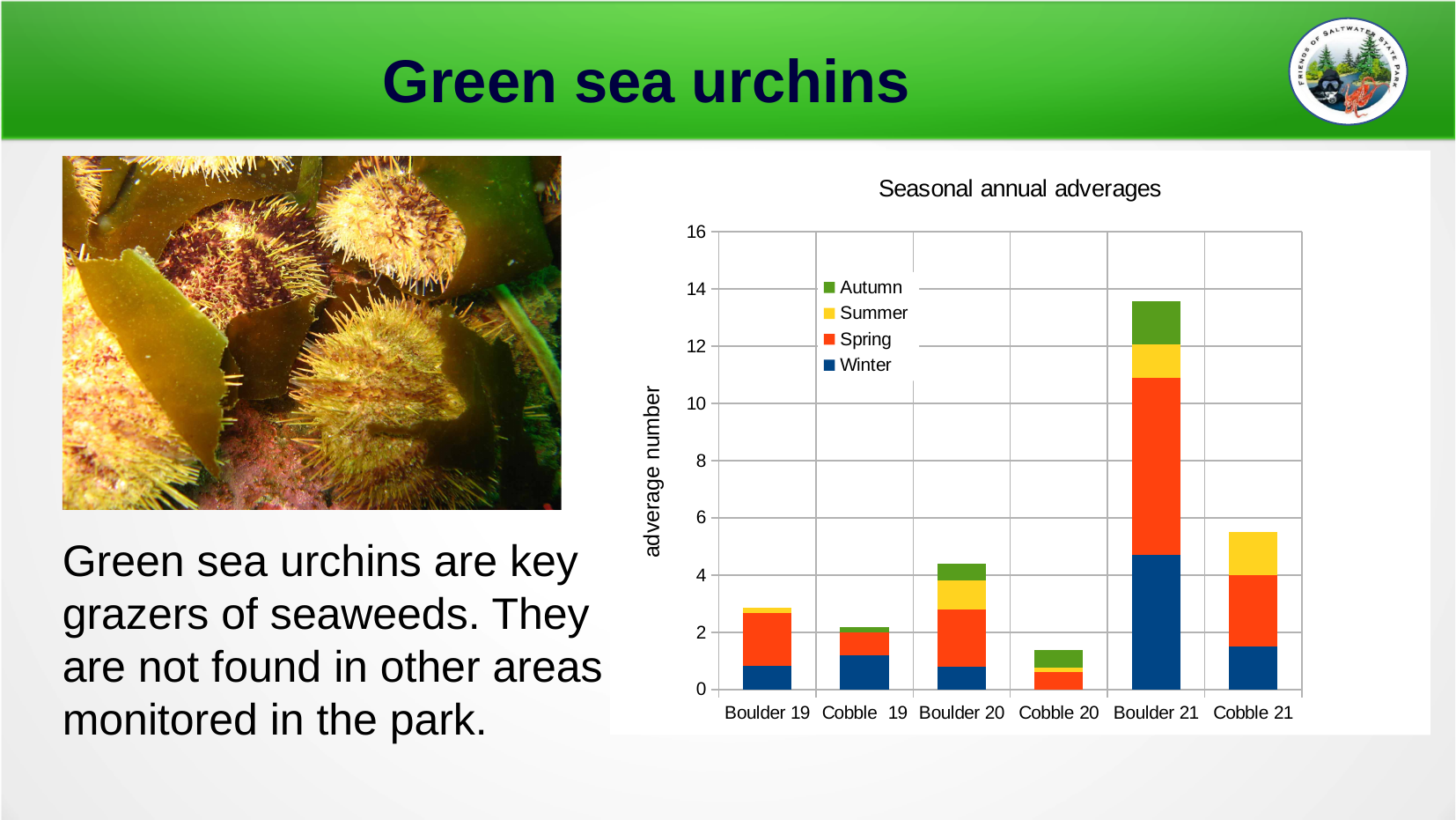
What is the label on the y axis of the chart? adverage number Which category has the highest total stacked bar? Boulder 21 What kind of chart is shown on the slide? stacked bar chart Which has the larger total stacked bar, Boulder 21 or Cobble 21? Boulder 21 How many categories are shown along the x axis of the chart? 6 What is the title of the chart? Seasonal annual adverages Is the total stacked value for Boulder 19 greater or less than 4? less Is the total stacked value for Cobble 20 greater or less than 2? less How many series does the chart legend list? 4 Is the Winter value for Boulder 21 greater or less than 4? greater Which category has the lowest total stacked bar? Cobble 20